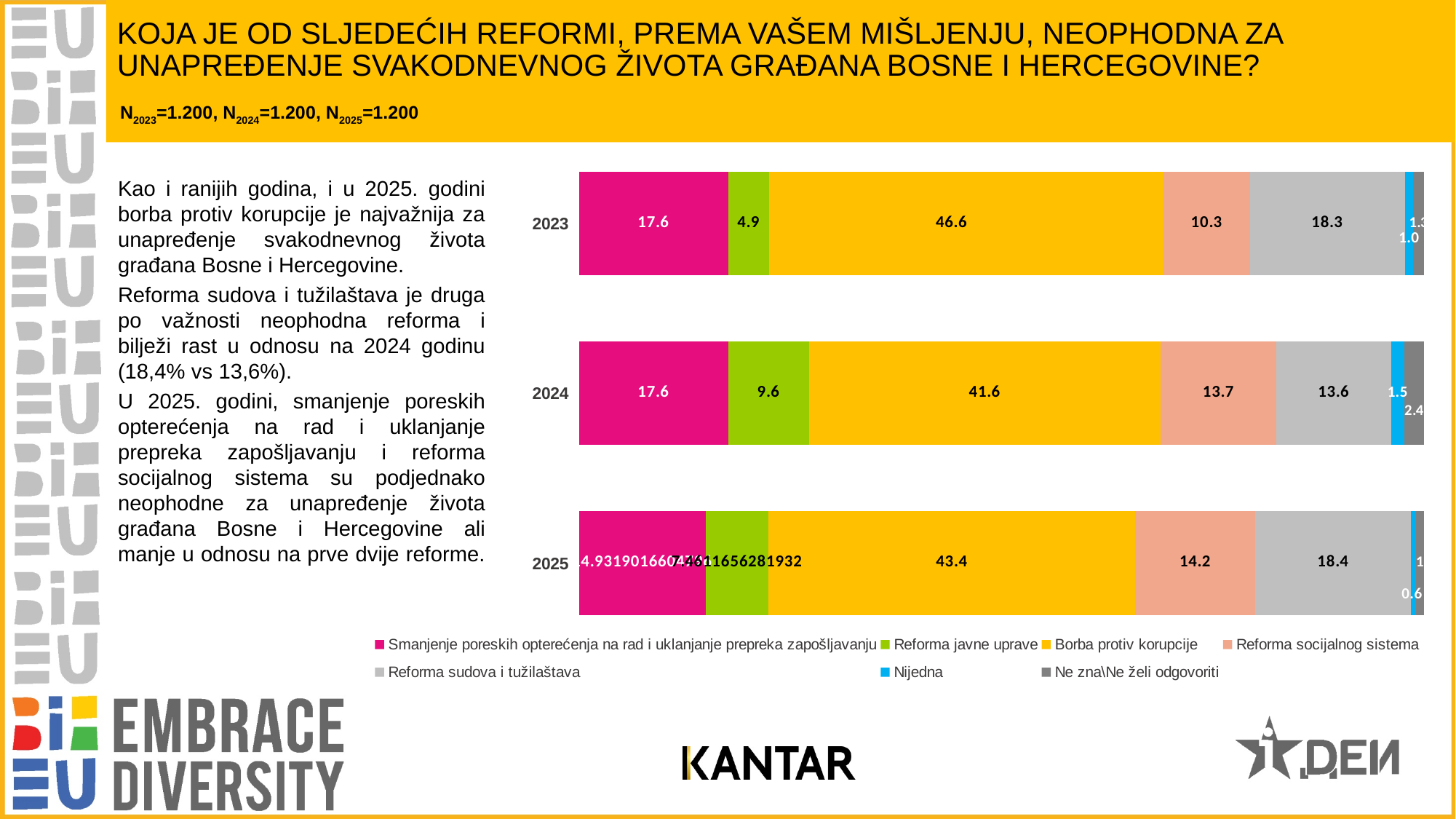
What is the difference between the 'Borba protiv korupcije' values in 2023 and 2024? 5.0 How many series does the legend list? 7 What is the value for 'Borba protiv korupcije' in 2023? 46.6 What is the value for 'Reforma sudova i tužilaštava' in 2025? 18.4 What kind of chart is shown on the slide? stacked bar chart What is the value for 'Reforma socijalnog sistema' in 2023? 10.3 In which year is the value for 'Borba protiv korupcije' the highest? 2023 How many years (bars) are shown in the chart? 3 In which year is the value for 'Reforma sudova i tužilaštava' the lowest? 2024 Which is larger: 'Reforma socijalnog sistema' in 2024 or in 2025? 2025 What is the value for 'Reforma javne uprave' in 2024? 9.6 Which series is shown in yellow in the chart? Borba protiv korupcije